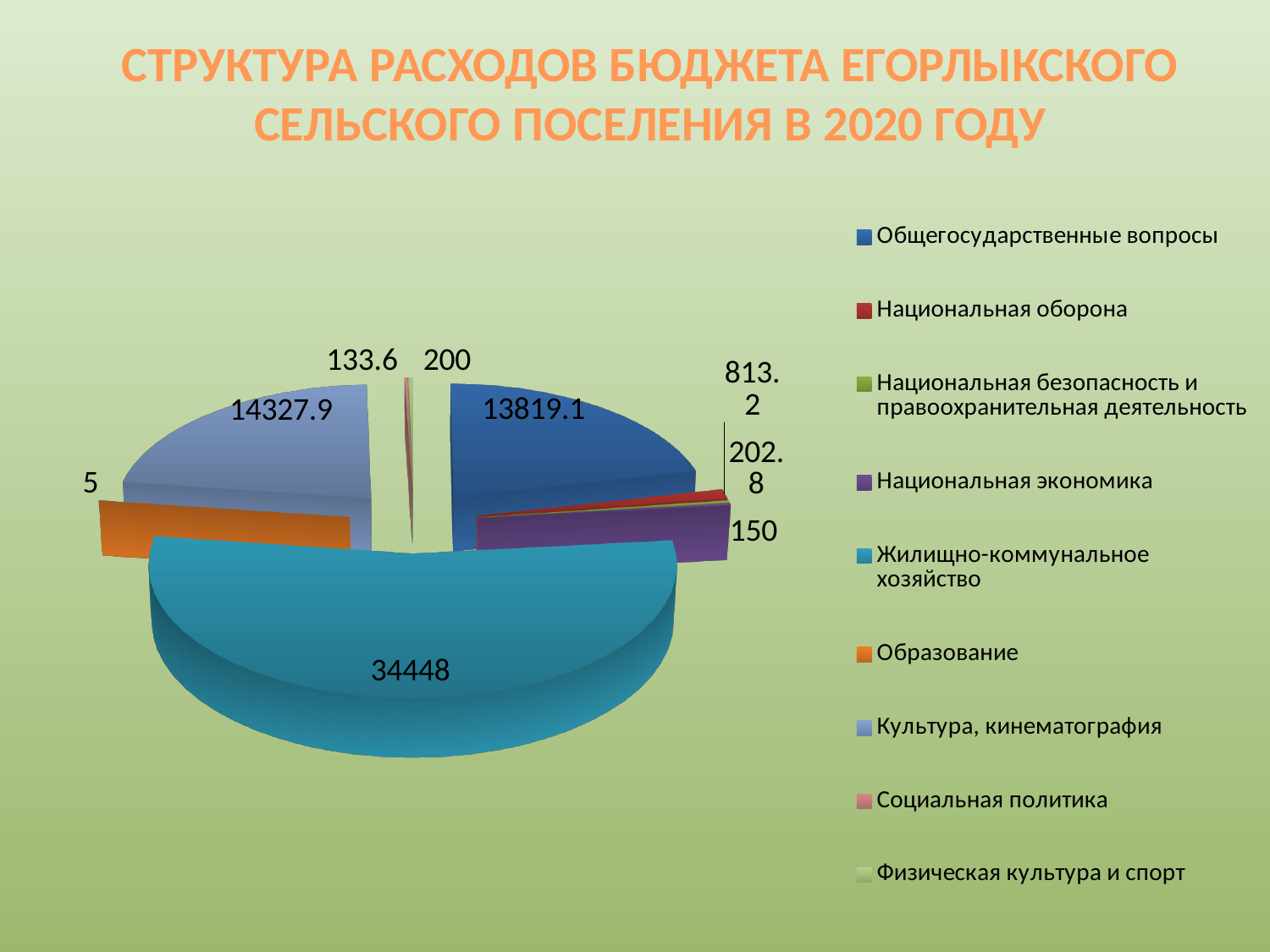
What is the difference between the values for Физическая культура и спорт and Социальная политика? 66.4 Which is larger: Национальная оборона or Национальная безопасность и правоохранительная деятельность? Национальная оборона What is the value for Культура, кинематография? 14327.9 What kind of chart is shown on the slide? Pie chart Which category has the largest slice of the pie? Жилищно-коммунальное хозяйство What is the value for Жилищно-коммунальное хозяйство? 34448 Which category has the smallest value? Образование What is the value for Образование? 5 What is the value for Общегосударственные вопросы? 13819.1 What is the value for Национальная оборона? 813.2 How many categories does the legend list? 9 What is the difference between the values for Культура, кинематография and Общегосударственные вопросы? 508.8